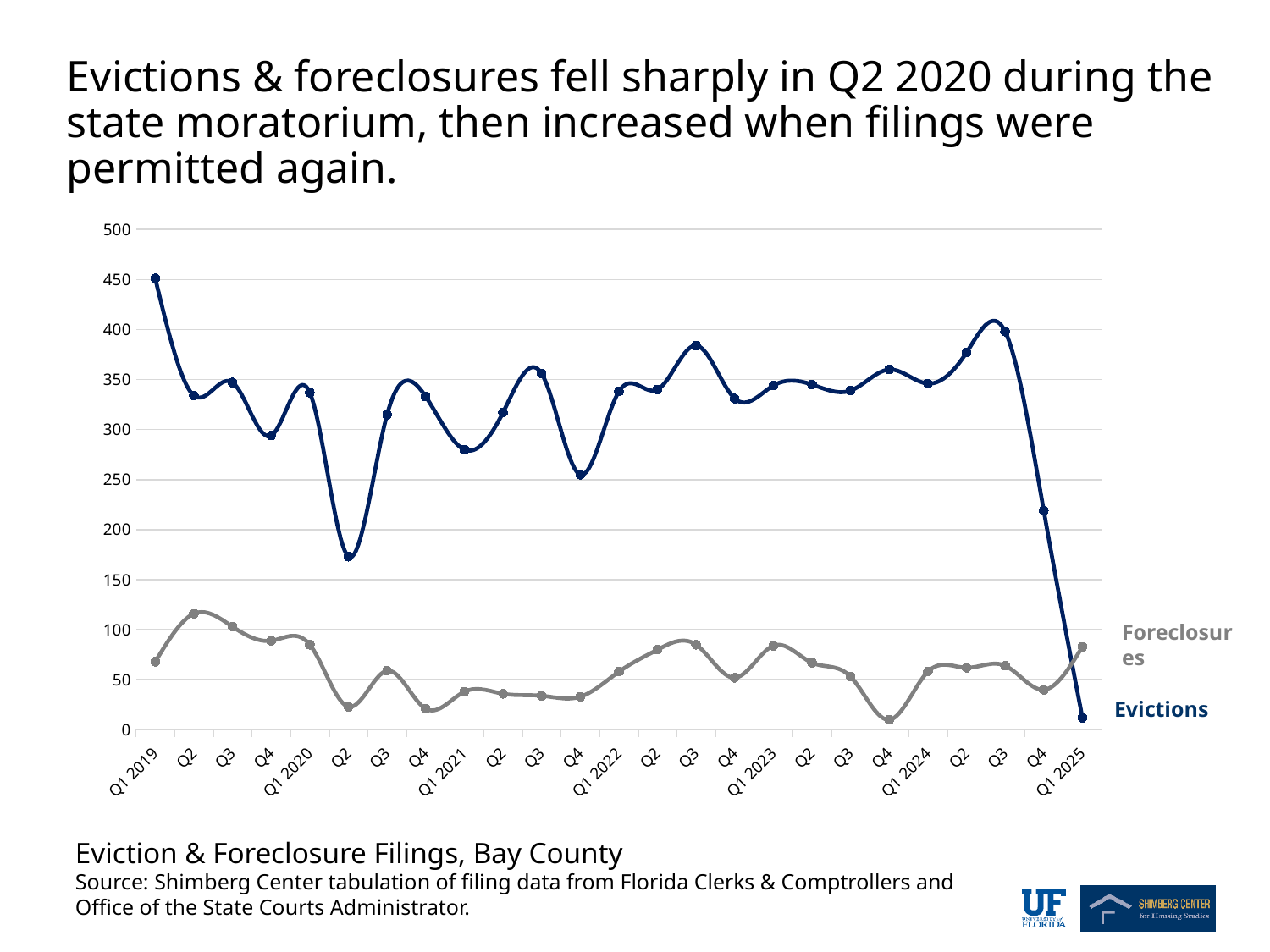
Is the Evictions value for Q2 2020 greater or less than 200? less In which quarter is the Evictions series at its highest? Q1 2019 In which quarter is the Evictions series at its lowest? Q1 2025 In which quarter is the Foreclosures series at its highest? Q2 2019 Is the Evictions value for Q3 2024 greater or less than 350? greater What kind of chart is shown on the slide? line chart How many quarterly data points are plotted along the x axis for each series? 25 In Q1 2019, which series has the larger value, Evictions or Foreclosures? Evictions Is the Foreclosures value for Q4 2023 greater or less than 50? less How many series does the chart show? 2 In Q1 2025, which series has the larger value, Evictions or Foreclosures? Foreclosures What is the title of the chart given below the plot area? Eviction & Foreclosure Filings, Bay County